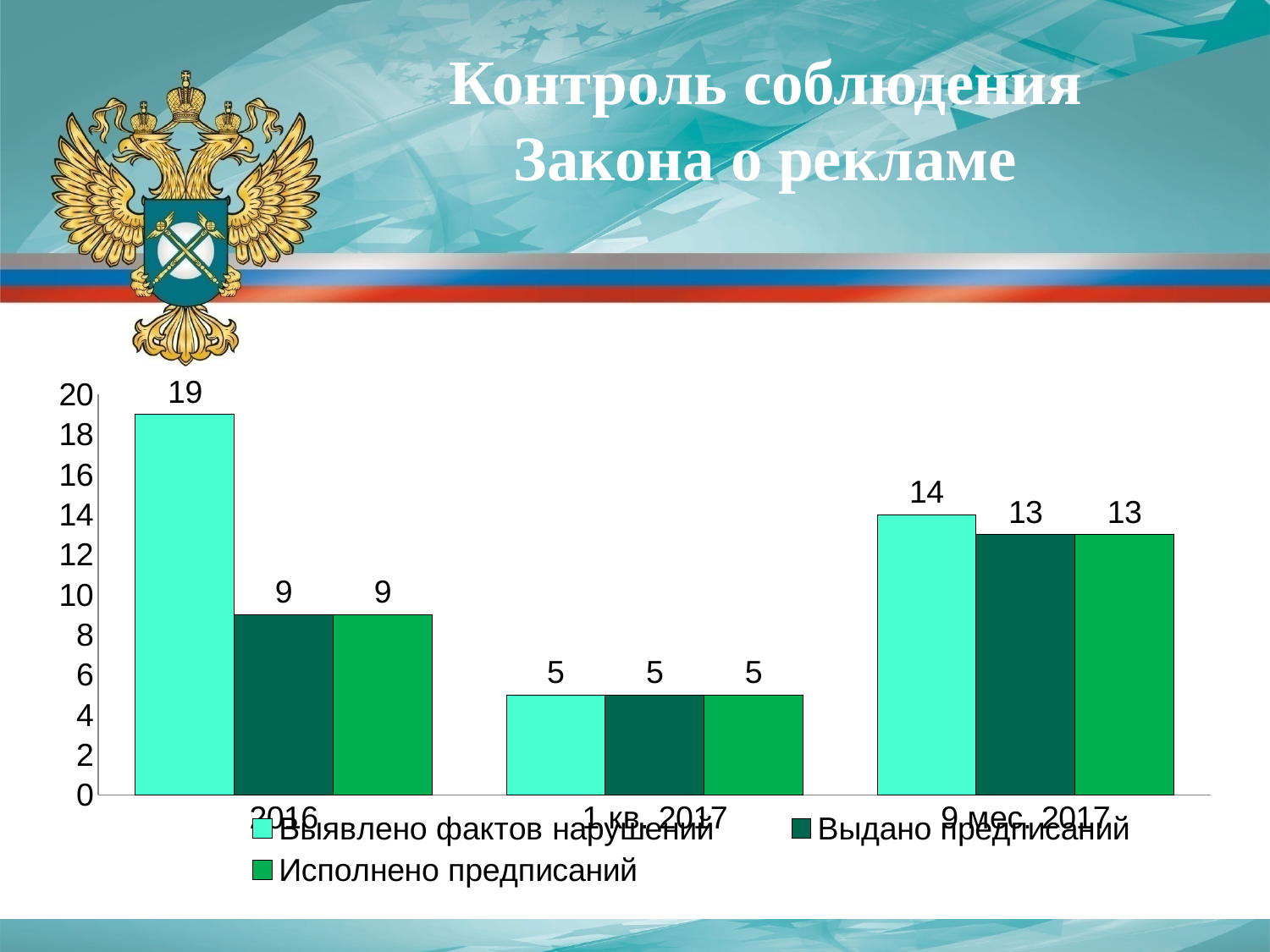
How many series does the legend list? 3 What is the value of Выявлено фактов нарушений for 2016? 19 Which category has the highest value for Выявлено фактов нарушений? 2016 Which is larger: Выявлено фактов нарушений for 9 мес. 2017 or for 1 кв. 2017? 9 мес. 2017 What is the title of the slide? Контроль соблюдения Закона о рекламе What is the value of Выдано предписаний for 9 мес. 2017? 13 Is the value of Выявлено фактов нарушений for 2016 greater or less than 16? greater Which category has the lowest value for Выдано предписаний? 1 кв. 2017 What is the value of Исполнено предписаний for 1 кв. 2017? 5 What is the difference between Выявлено фактов нарушений and Выдано предписаний in 2016? 10 What kind of chart is shown on the slide? bar chart How many categories are shown on the x axis? 3